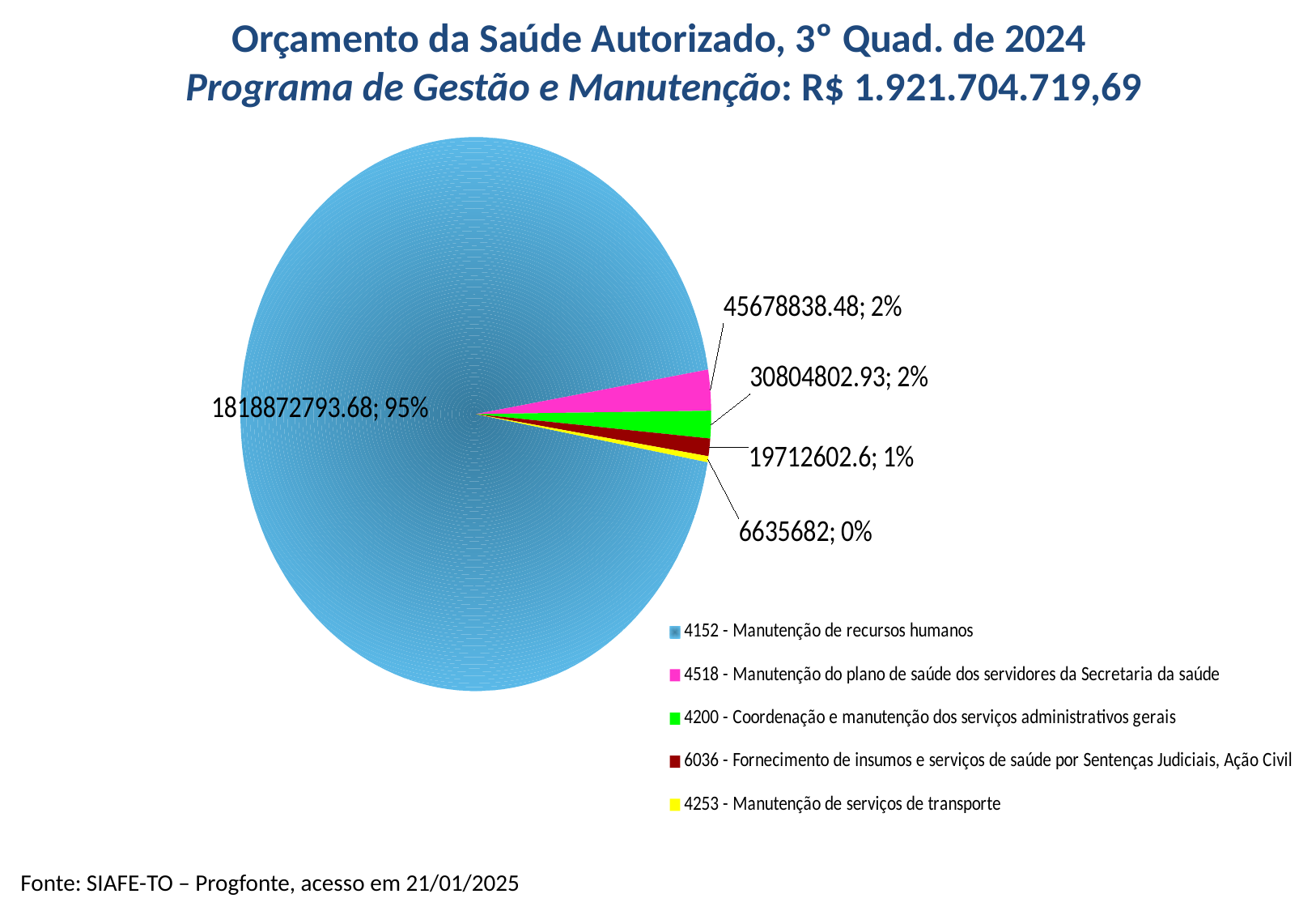
What type of chart is shown on the slide? pie chart How many slices does the pie chart have? 5 What is the difference between the value for 6036 - Fornecimento de insumos e serviços de saúde por Sentenças Judiciais, Ação Civil and the value for 4253 - Manutenção de serviços de transporte? 13076920.6 What is the value for 4253 - Manutenção de serviços de transporte? 6635682 How many entries does the legend list? 5 What is the value for 4518 - Manutenção do plano de saúde dos servidores da Secretaria da saúde? 45678838.48 What share of the pie does 6036 - Fornecimento de insumos e serviços de saúde por Sentenças Judiciais, Ação Civil represent? 1% What is the value for 4152 - Manutenção de recursos humanos? 1818872793.68 What is the value for 4200 - Coordenação e manutenção dos serviços administrativos gerais? 30804802.93 What share of the pie does 4152 - Manutenção de recursos humanos represent? 95% Which is larger, the value for 4518 - Manutenção do plano de saúde dos servidores da Secretaria da saúde or the value for 4200 - Coordenação e manutenção dos serviços administrativos gerais? 4518 - Manutenção do plano de saúde dos servidores da Secretaria da saúde Which category has the smallest slice? 4253 - Manutenção de serviços de transporte